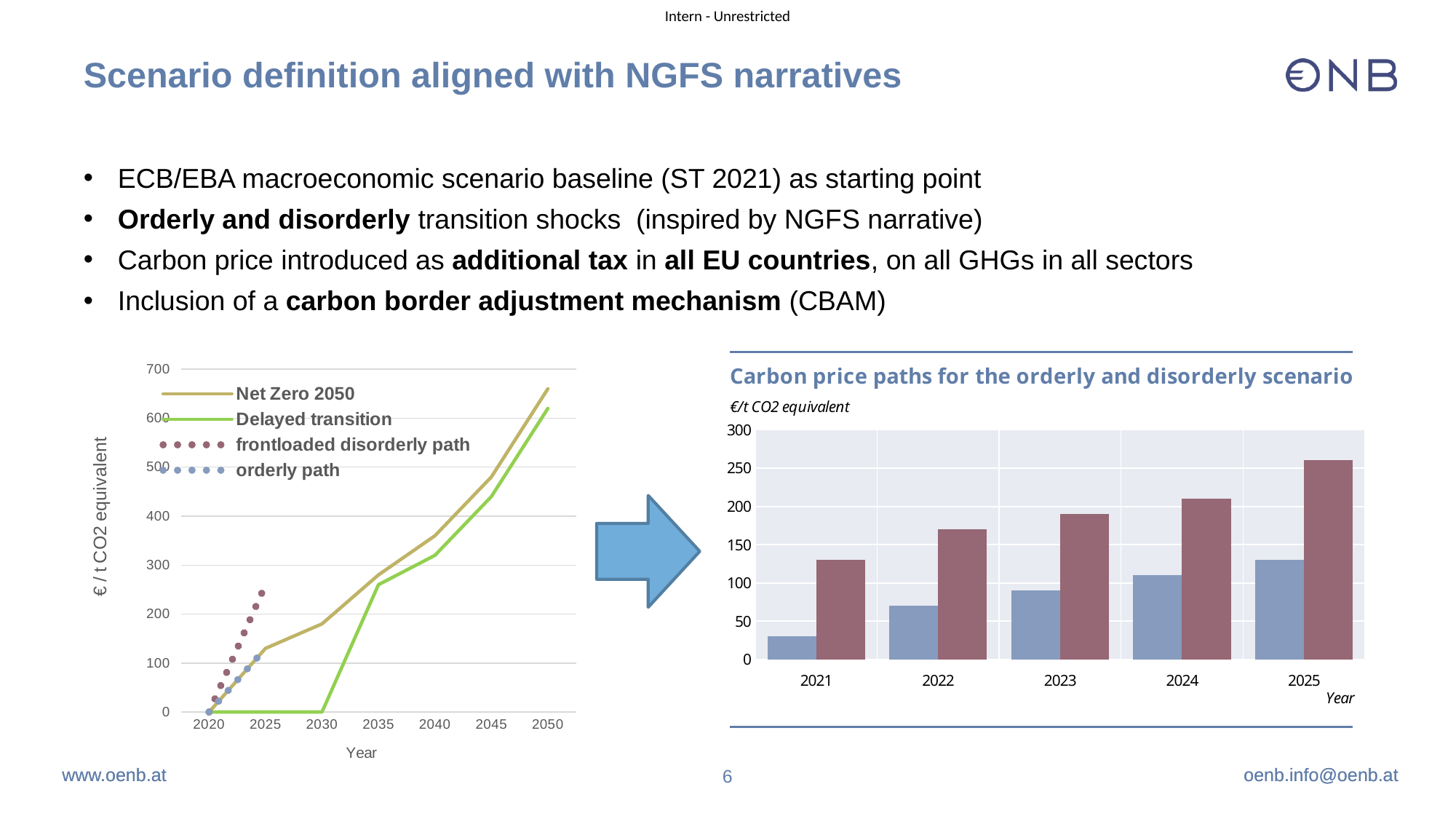
How many years are shown on the x axis of the right chart 'Carbon price paths for the orderly and disorderly scenario'? 5 What is the unit shown on the y axis of the left chart? € / t CO2 equivalent How many series does the legend of the left chart list? 4 What type of chart is the chart on the left of the slide? line chart In the right chart 'Carbon price paths for the orderly and disorderly scenario', do the blue bars rise or fall from 2021 to 2025? rise In the right chart 'Carbon price paths for the orderly and disorderly scenario', is the red bar for 2025 greater or less than 250? greater In the right chart 'Carbon price paths for the orderly and disorderly scenario', is the blue bar for 2021 greater or less than 50? less In the right chart 'Carbon price paths for the orderly and disorderly scenario', which year has the lowest blue bar? 2021 In the right chart 'Carbon price paths for the orderly and disorderly scenario', is the red bar for 2023 larger or smaller than the blue bar for 2023? larger What type of chart is the chart on the right titled 'Carbon price paths for the orderly and disorderly scenario'? bar chart In the right chart 'Carbon price paths for the orderly and disorderly scenario', which year has the highest red bar? 2025 In the left chart, is the value of the 'Net Zero 2050' line in 2050 greater or less than 600? greater